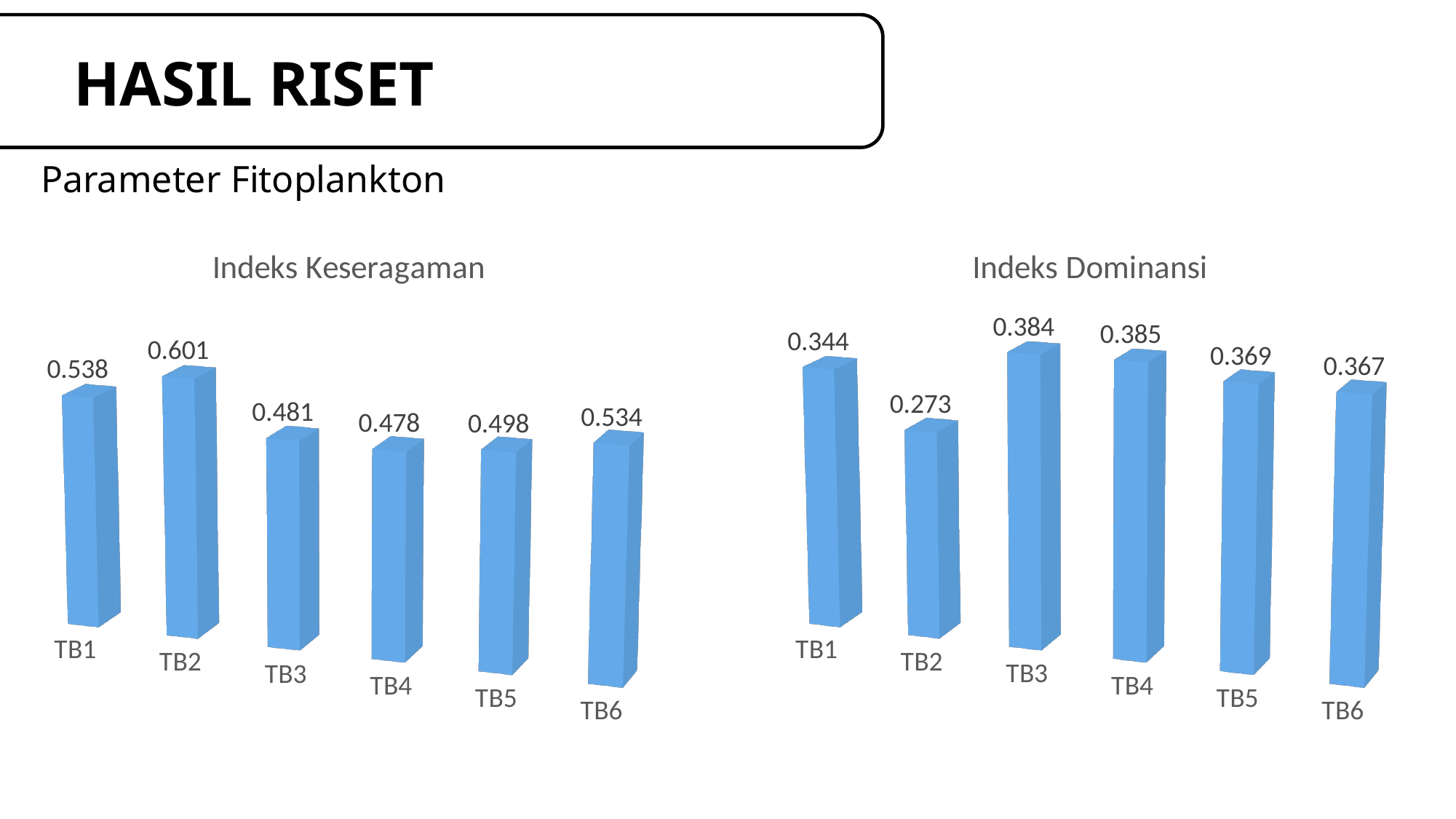
In the Indeks Dominansi chart, what is the difference between the values for TB3 and TB2? 0.111 In the Indeks Keseragaman chart, what is the value for TB4? 0.478 In the Indeks Keseragaman chart, what is the value for TB2? 0.601 In the Indeks Keseragaman chart, which category has the highest value? TB2 In the Indeks Dominansi chart, what is the value for TB1? 0.344 What kind of chart is the Indeks Dominansi chart? Bar chart In the Indeks Dominansi chart, which is larger, the value for TB1 or the value for TB5? TB5 In the Indeks Dominansi chart, which category has the lowest value? TB2 In the Indeks Dominansi chart, what is the value for TB6? 0.367 In the Indeks Keseragaman chart, which category has the lowest value? TB4 In the Indeks Keseragaman chart, how many categories are plotted? 6 In the Indeks Keseragaman chart, what is the difference between the values for TB2 and TB3? 0.120